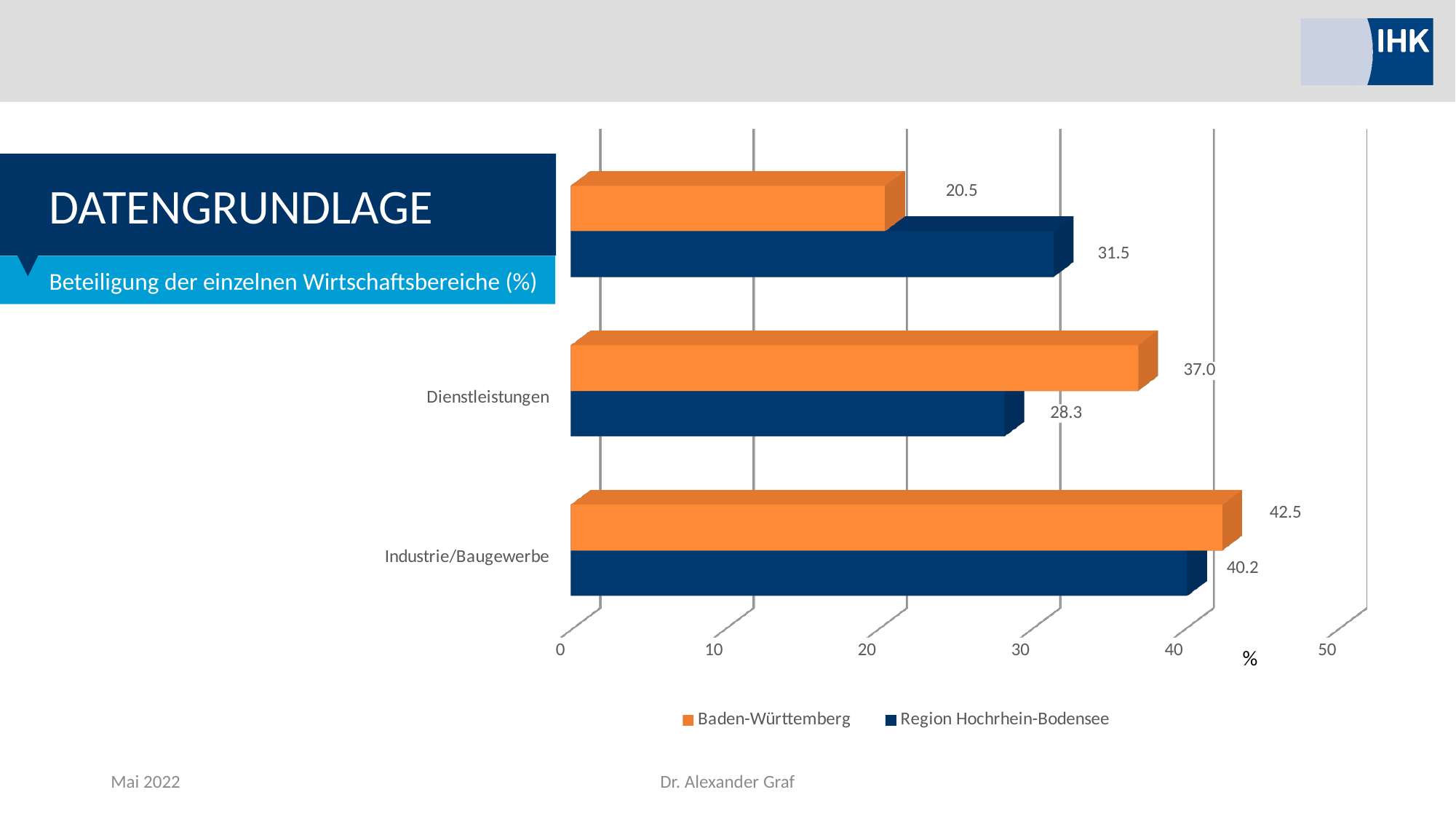
Which category has the highest value for Baden-Württemberg? Industrie/Baugewerbe What is the value for Baden-Württemberg in the Industrie/Baugewerbe category? 42.5 What is the value for Region Hochrhein-Bodensee in the Dienstleistungen category? 28.3 What is the value for Region Hochrhein-Bodensee in the Industrie/Baugewerbe category? 40.2 Which category has the lowest value for Region Hochrhein-Bodensee? Dienstleistungen What is the difference between Baden-Württemberg and Region Hochrhein-Bodensee in the Dienstleistungen category? 8.7 What kind of chart is shown on the slide? bar chart How many series does the legend list? 2 Is the value for Region Hochrhein-Bodensee in the Dienstleistungen category greater or less than 30? less In the Industrie/Baugewerbe category, which series has the larger value, Baden-Württemberg or Region Hochrhein-Bodensee? Baden-Württemberg Which colour represents Region Hochrhein-Bodensee in the chart? dark blue What is the value for Baden-Württemberg in the Dienstleistungen category? 37.0